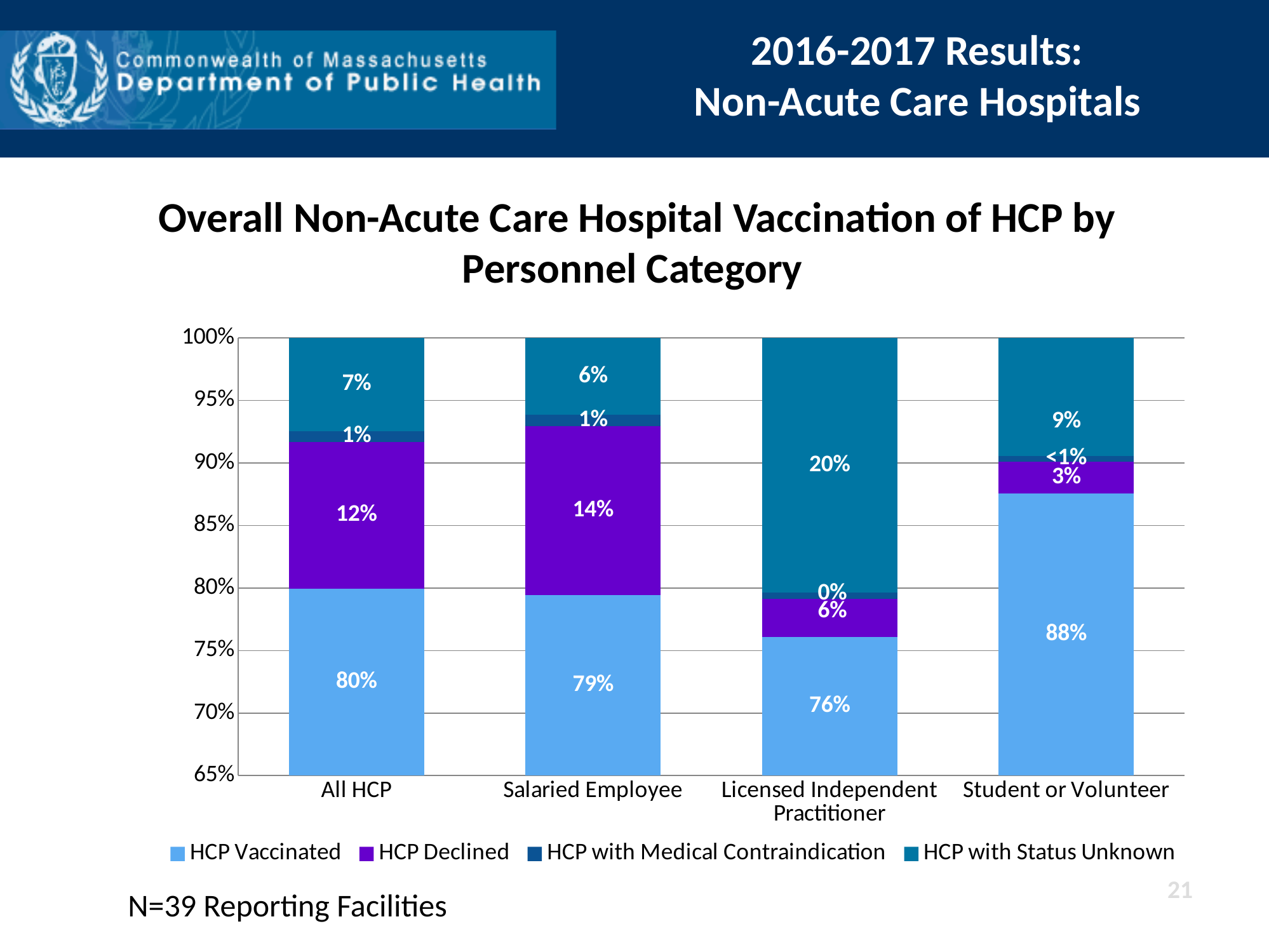
How many series does the legend list? 4 How many personnel categories are shown on the x axis? 4 Which is larger: the HCP Declined value for Salaried Employee or for Student or Volunteer? Salaried Employee What percentage of HCP were vaccinated in the All HCP category? 80% What is the title of the chart? Overall Non-Acute Care Hospital Vaccination of HCP by Personnel Category What is the HCP Declined value for Salaried Employee? 14% Which personnel category has the highest HCP Vaccinated percentage? Student or Volunteer What is the HCP with Status Unknown value for Licensed Independent Practitioner? 20% What is the difference between the HCP Vaccinated percentage for Student or Volunteer and for Licensed Independent Practitioner? 12% What is the HCP with Medical Contraindication value for Student or Volunteer? <1% What kind of chart is shown on the slide? Stacked bar chart Which personnel category has the lowest HCP Vaccinated percentage? Licensed Independent Practitioner